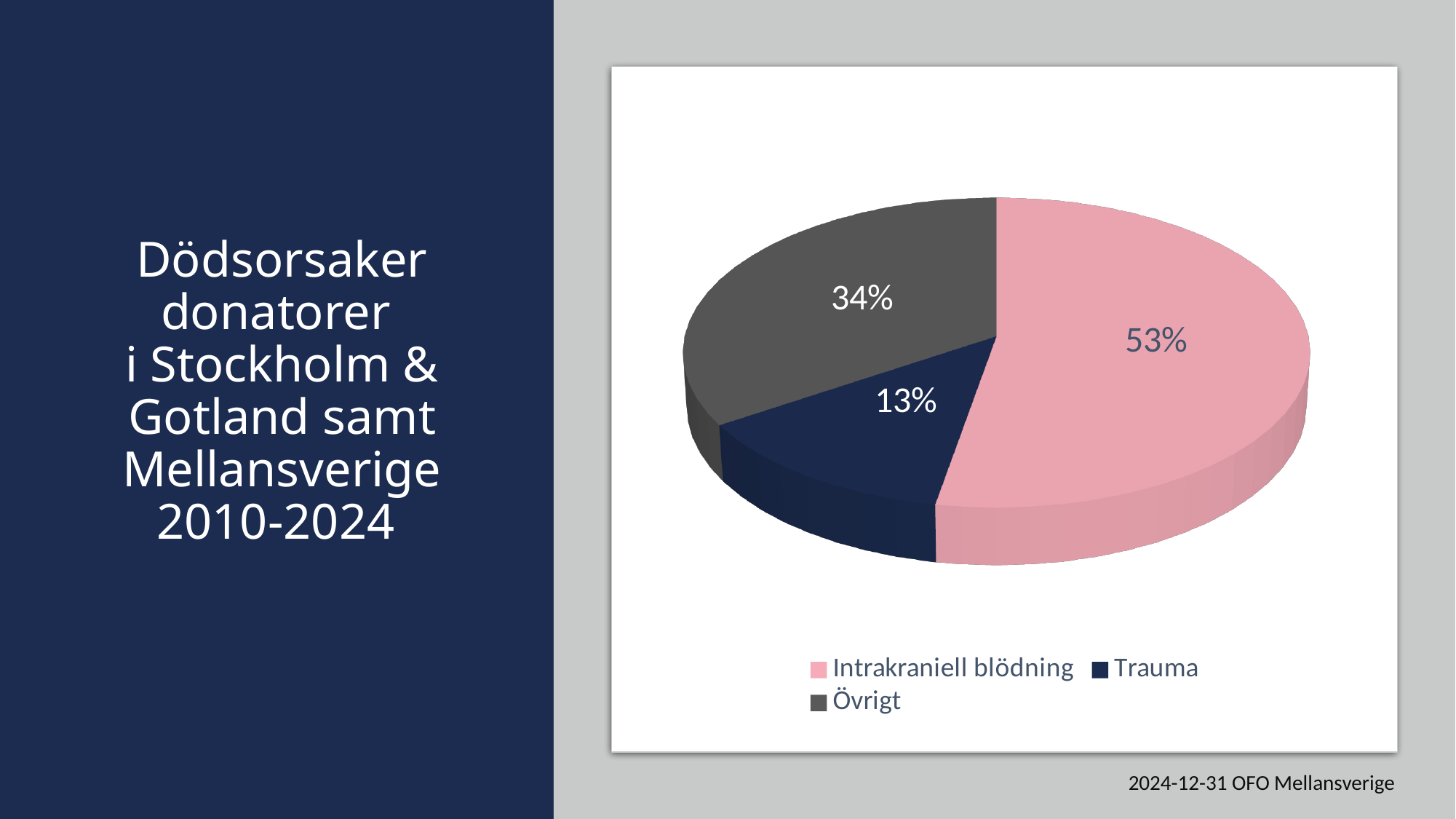
What kind of chart is shown on the slide? Pie chart Which category has the largest slice of the pie? Intrakraniell blödning What is the difference in percentage points between Intrakraniell blödning and Övrigt? 19 What share of the pie does Intrakraniell blödning represent? 53% Which category has the smallest slice of the pie? Trauma What is the difference in percentage points between Övrigt and Trauma? 21 Which category is shown in pink in the legend? Intrakraniell blödning What colour is the slice for Trauma? Dark navy blue What share of the pie does Trauma represent? 13% Which is larger, the share for Trauma or the share for Övrigt? Övrigt How many categories does the pie chart show? 3 What share of the pie does Övrigt represent? 34%